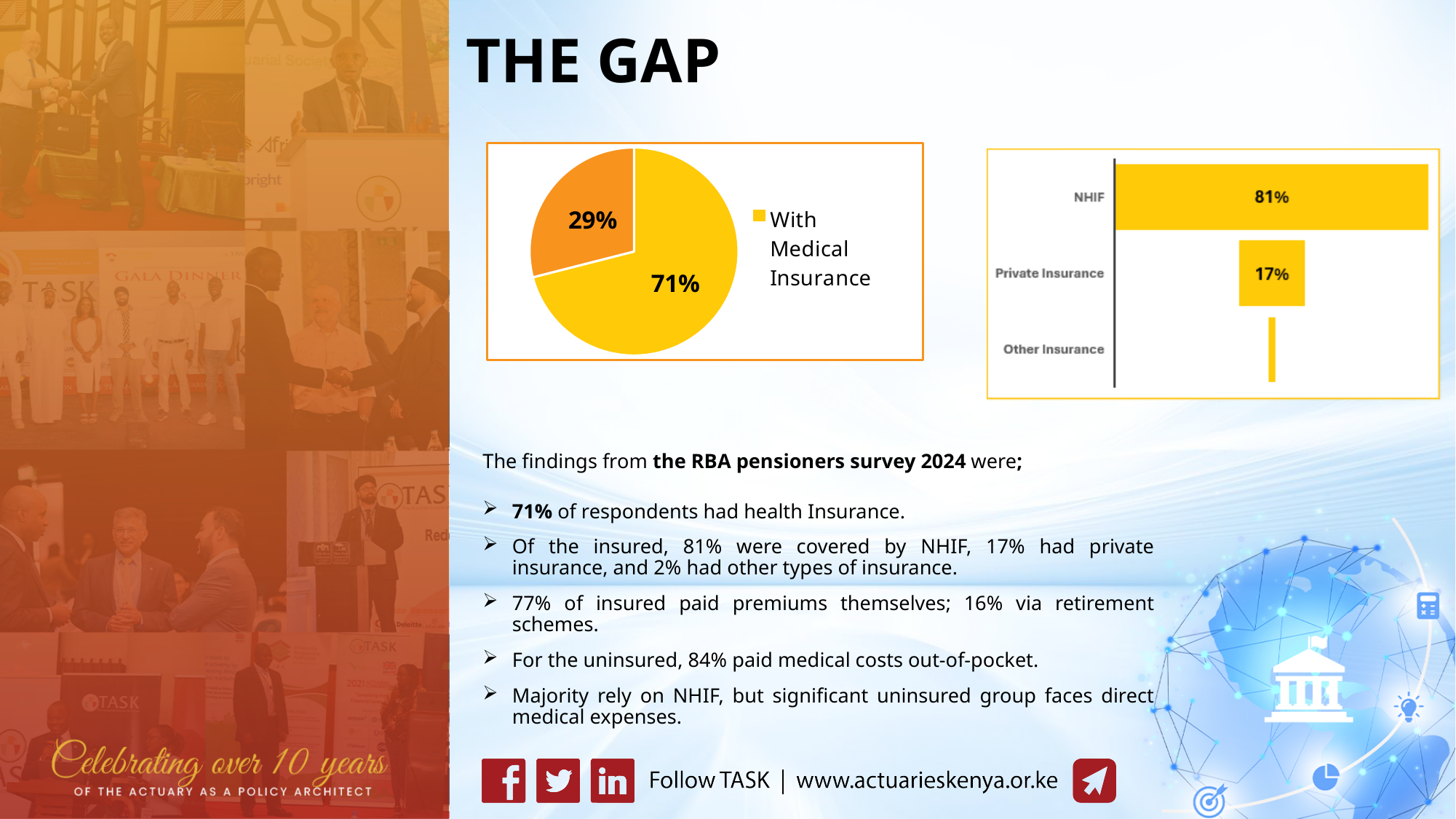
In the pie chart on the left, what share of the pie is labelled 'With Medical Insurance'? 71% In the bar chart on the right, what is the difference between the NHIF and Private Insurance values? 64% In the bar chart on the right, what is the value for Private Insurance? 17% In the bar chart on the right, which category has the lowest value? Other Insurance In the bar chart on the right, what is the value for NHIF? 81% What kind of chart is the chart on the left of the slide? pie chart What kind of chart is the chart on the right of the slide? bar chart In the bar chart on the right, which category has the highest value? NHIF In the pie chart on the left, what is the difference between the two slice values? 42% In the bar chart on the right, how many categories are shown? 3 In the pie chart on the left, how many slices are there? 2 In the pie chart on the left, what is the value shown on the orange slice? 29%